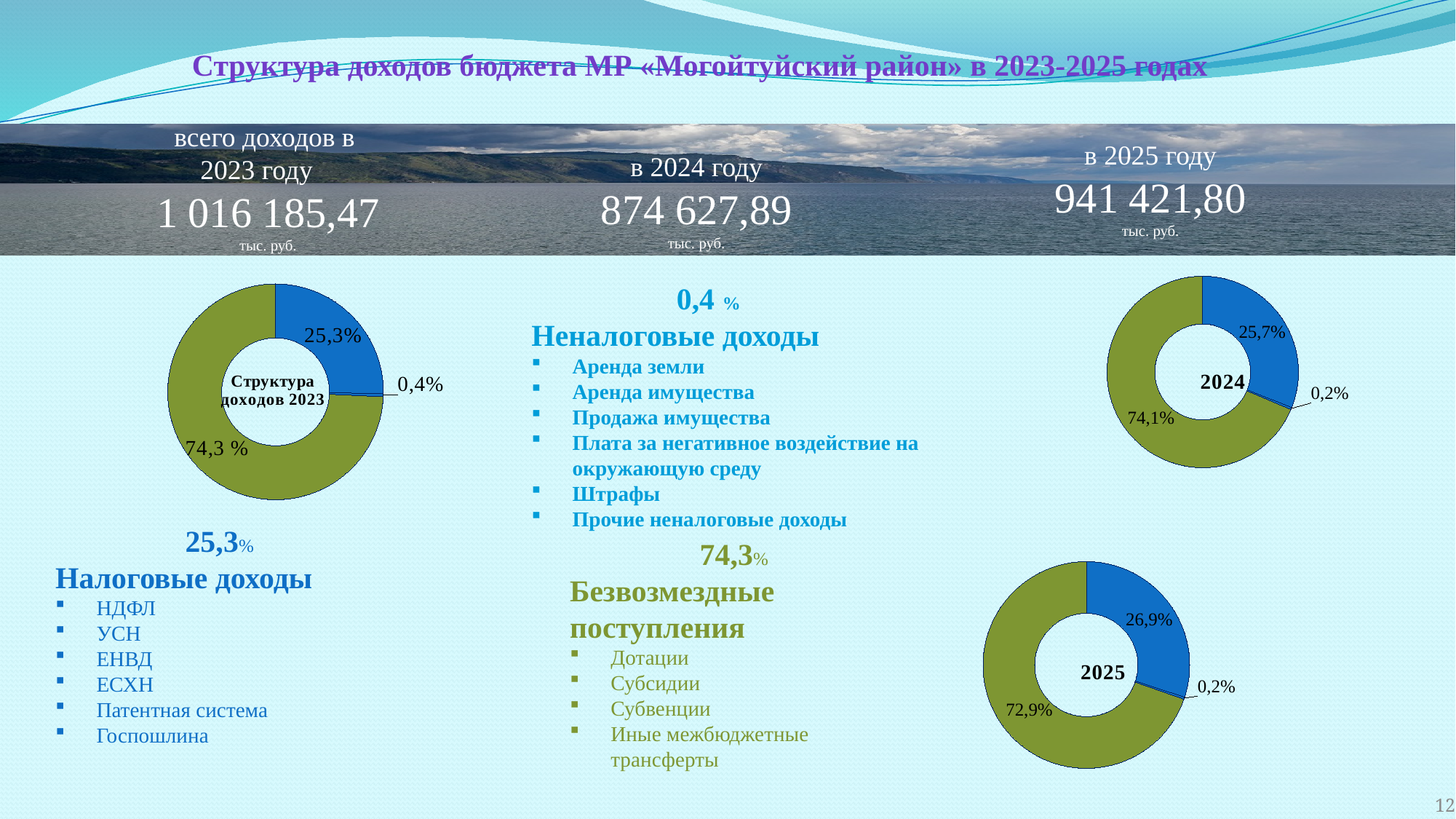
In the "2024" chart, what share does the green slice have? 74,1% In the "2024" chart, which slice is the smallest? the 0,2% slice In the "Структура доходов 2023" chart, what share does the green slice (Безвозмездные поступления) have? 74,3 % In the "2025" chart, which slice is the largest? the green slice (72,9%) In the "2024" chart, what share does the blue slice have? 25,7% In the "Структура доходов 2023" chart, what share does the smallest slice (Неналоговые доходы) have? 0,4% In the "2025" chart, what is the difference between the green slice (72,9%) and the blue slice (26,9%)? 46 percentage points What kind of chart is the "Структура доходов 2023" chart? doughnut chart In the "Структура доходов 2023" chart, what share does the blue slice (Налоговые доходы) have? 25,3% How many slices does the "2025" chart have? 3 In the "2025" chart, what share does the green slice have? 72,9% In the "2025" chart, what share does the blue slice have? 26,9%